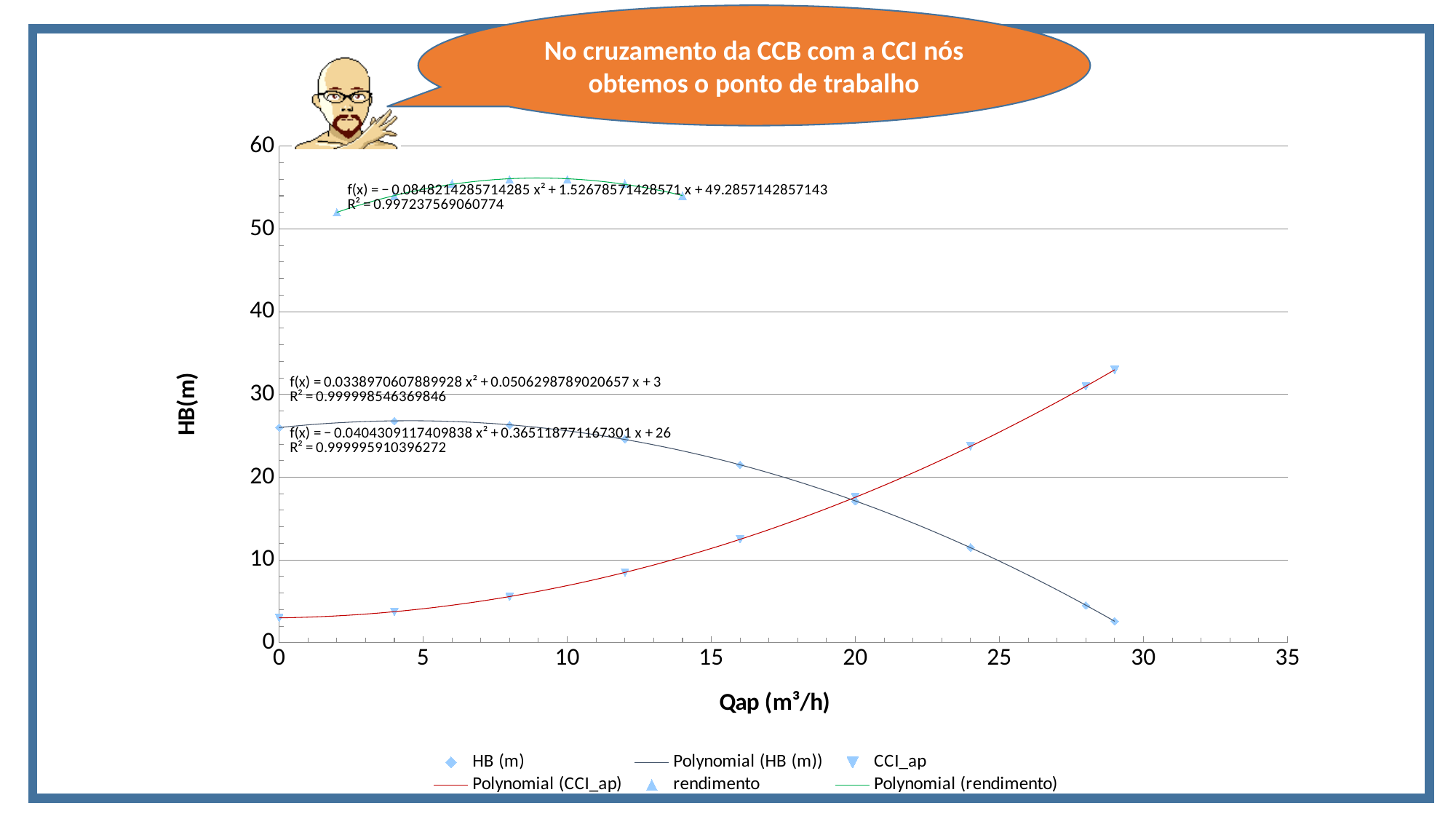
Is the rendimento value at Qap = 10 greater or less than 50? greater What is the constant term in the printed polynomial equation for the CCI_ap trendline? 3 At Qap = 4, which series has the larger value, HB (m) or CCI_ap? HB (m) How many entries does the chart legend list? 6 Do the CCI_ap values rise or fall as Qap increases along the x axis? rise How many data points are plotted for the rendimento series? 7 Is the CCI_ap value at Qap = 28 greater or less than 30? greater What is the title of the x axis? Qap (m³/h) Is the HB (m) value at Qap = 28 greater or less than 10? less What kind of chart is shown on the slide? scatter chart What is the title of the y axis? HB(m) Do the HB (m) values rise or fall as Qap increases from 10 to 29 along the x axis? fall